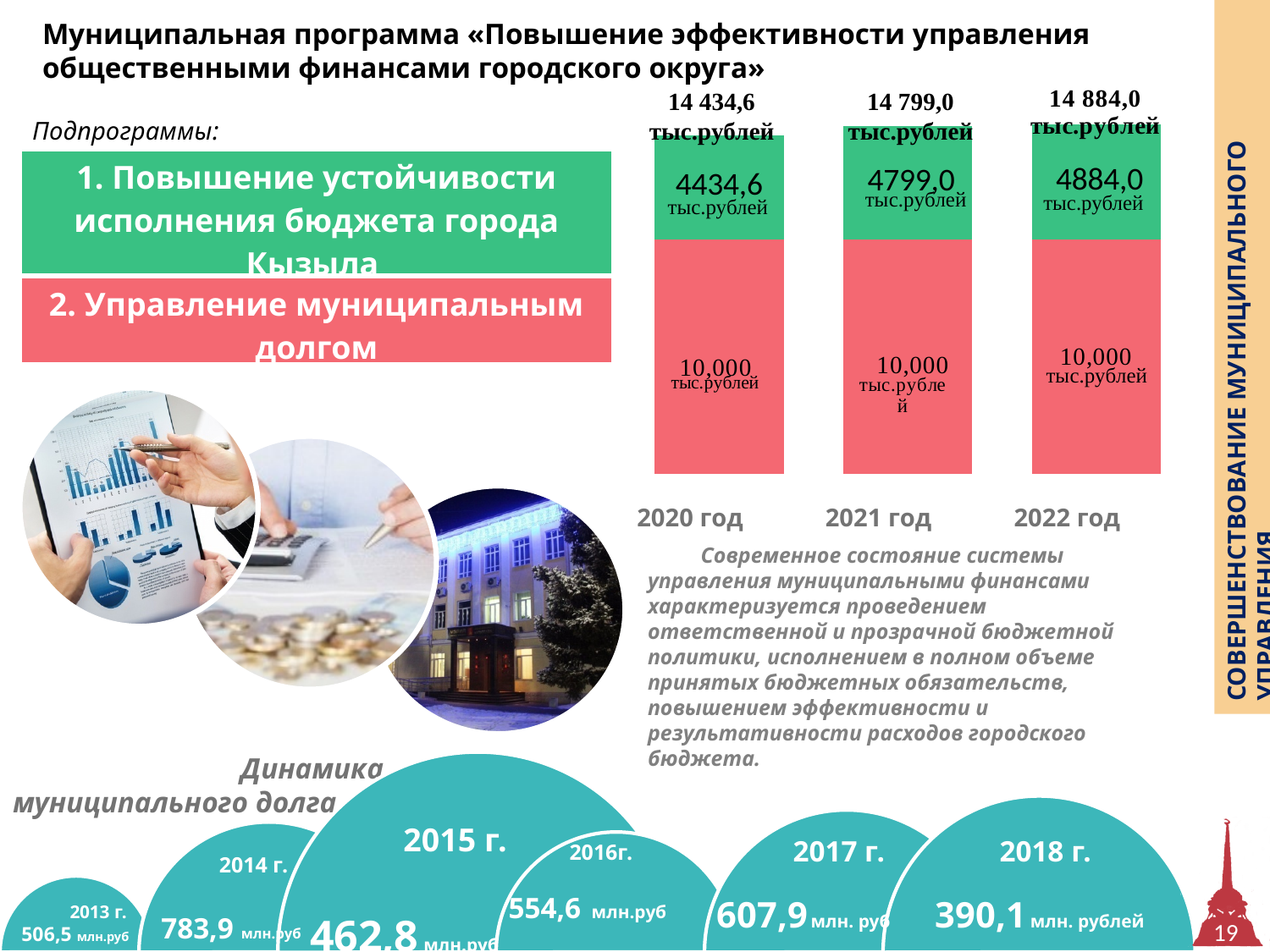
Does the green (upper) segment rise or fall from 2020 год to 2022 год in the stacked bar chart? rises In the stacked bar chart, what is the value of the green (upper) segment for 2022 год? 4884,0 тыс.рублей In the stacked bar chart, what is the value of the green (upper) segment for 2020 год? 4434,6 тыс.рублей In the stacked bar chart, what is the total value printed above the bar for 2022 год? 14 884,0 тыс.рублей In the stacked bar chart, what is the value of the green (upper) segment for 2021 год? 4799,0 тыс.рублей In the stacked bar chart, what is the value of the red (lower) segment for 2021 год? 10,000 тыс.рублей How many years (bars) are shown in the stacked bar chart? 3 In the stacked bar chart, by how much does the green segment for 2022 год exceed the green segment for 2021 год? 85,0 тыс.рублей In the stacked bar chart, what is the difference between the totals for 2021 год and 2020 год? 364,4 тыс.рублей In the stacked bar chart, which year has the highest total? 2022 год In the stacked bar chart, which year has the smallest green (upper) segment? 2020 год In the stacked bar chart, what is the total value printed above the bar for 2020 год? 14 434,6 тыс.рублей